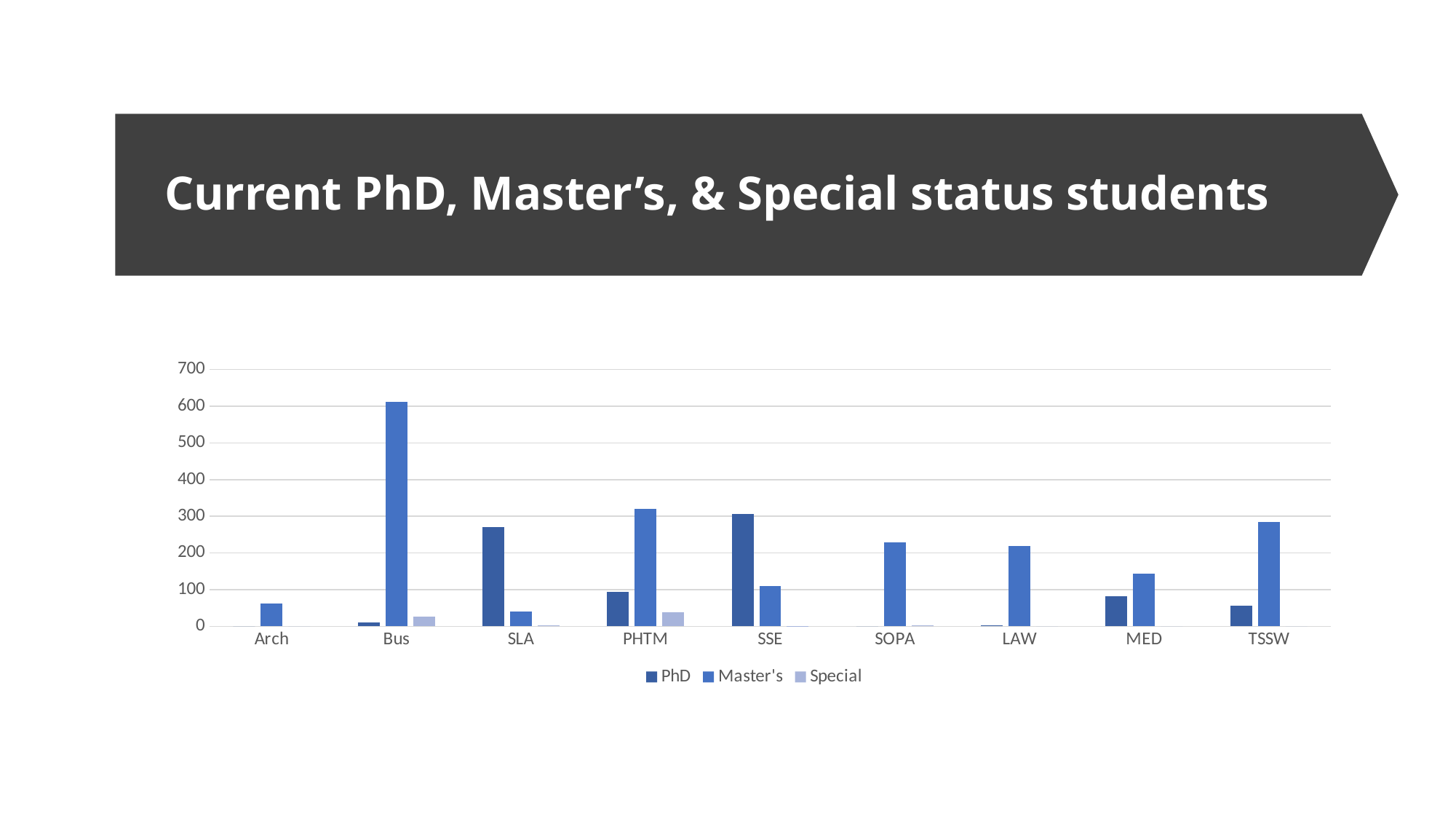
What is the title of the slide containing the chart? Current PhD, Master's, & Special status students How many series does the legend list? 3 Is the Master's value for Bus greater or less than 500? greater Which category has the highest Master's value? Bus For MED, which is larger, the PhD value or the Master's value? Master's Which category has the highest PhD value? SSE What kind of chart is shown on the slide? bar chart Is the Master's value for Arch greater or less than 100? less How many categories are shown on the x axis? 9 Is the PhD value for SLA greater or less than 200? greater For SSE, which is larger, the PhD value or the Master's value? PhD